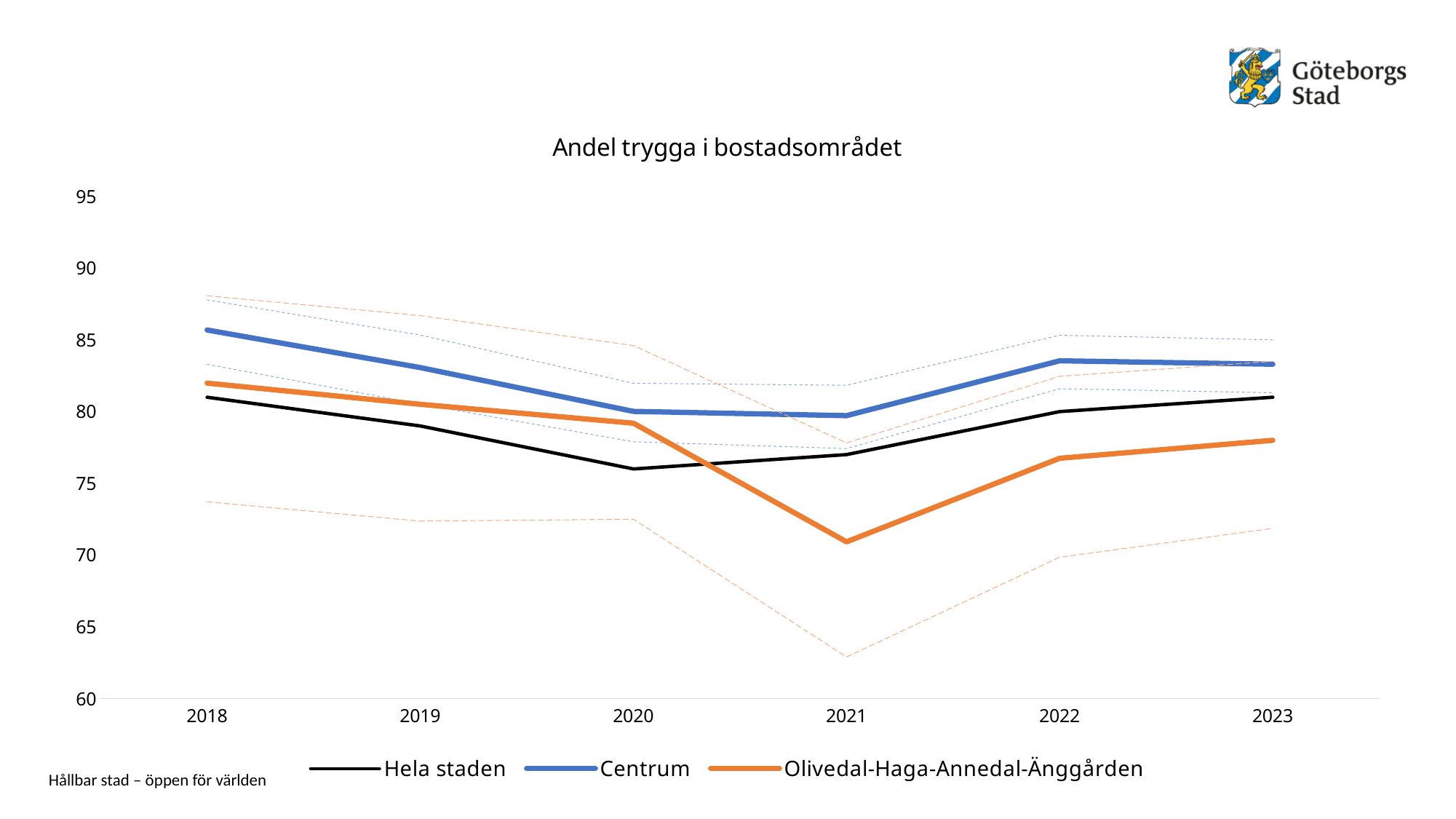
Is the value for Olivedal-Haga-Annedal-Änggården in 2021 greater or less than 75? less Is the value for Hela staden in 2020 greater or less than 80? less In which year is the value for Centrum highest? 2018 Does the value for Olivedal-Haga-Annedal-Änggården rise or fall from 2018 to 2021? fall What is the title of the chart? Andel trygga i bostadsområdet In which year is the value for Hela staden lowest? 2020 How many series does the legend list? 3 Is the value for Centrum in 2022 greater or less than 80? greater How many years are shown on the x axis? 6 In which year is the value for Olivedal-Haga-Annedal-Änggården lowest? 2021 What type of chart is shown on the slide? Line chart In 2021, which is larger: Centrum or Olivedal-Haga-Annedal-Änggården? Centrum